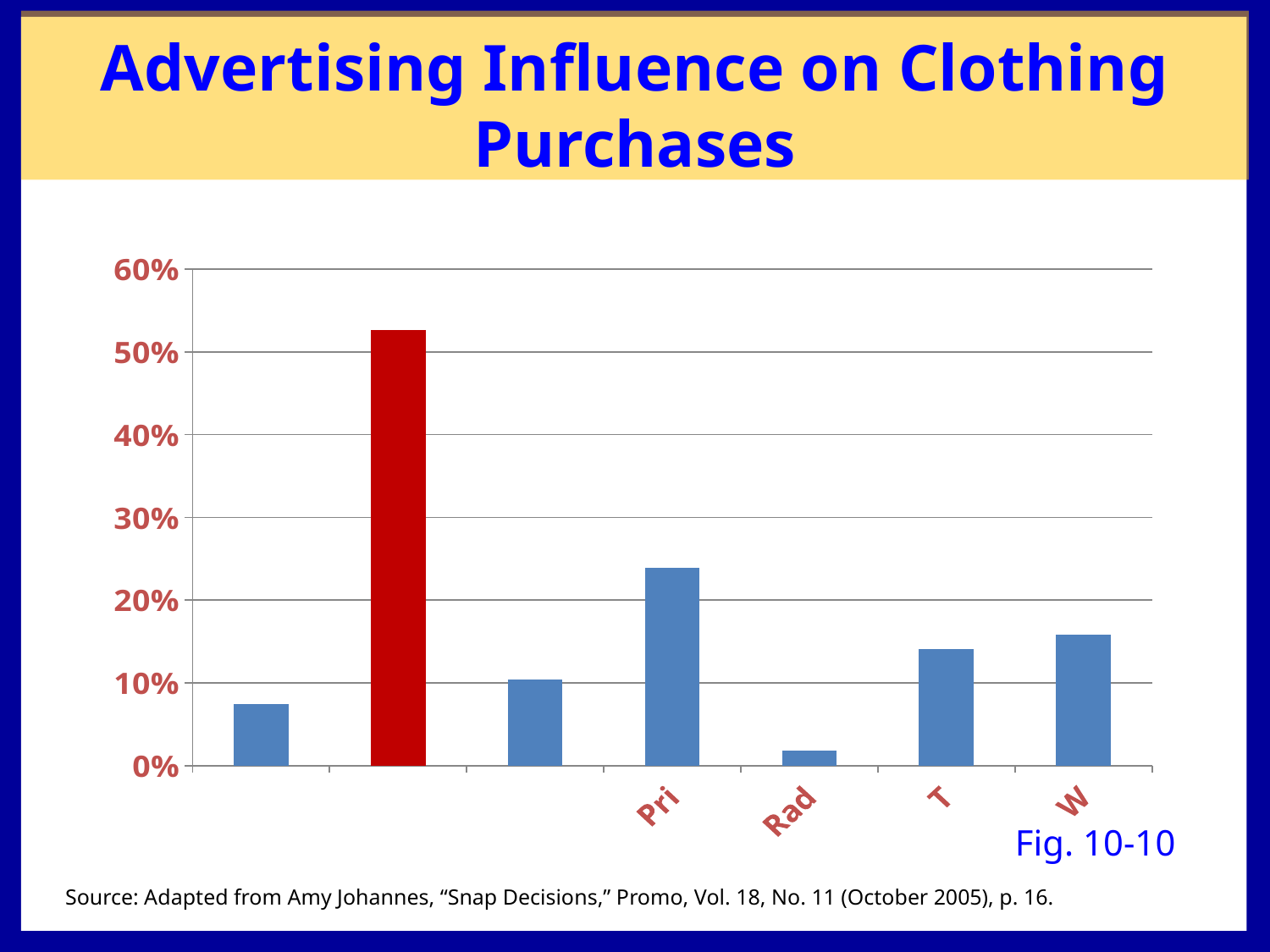
Which is larger, the value for Pri or the value for W? Pri Which bar is the tallest in the chart? the red bar, second from the left Is the value of the red bar greater or less than 50%? greater How many bars are plotted in the chart? 7 Is the value for Pri greater or less than 20%? greater Is the value for T greater or less than 10%? greater What kind of chart is shown on the slide? bar chart Which is larger, the value for T or the value for Rad? T What is the title of the slide containing the chart? Advertising Influence on Clothing Purchases Which labelled category has the lowest value? Rad